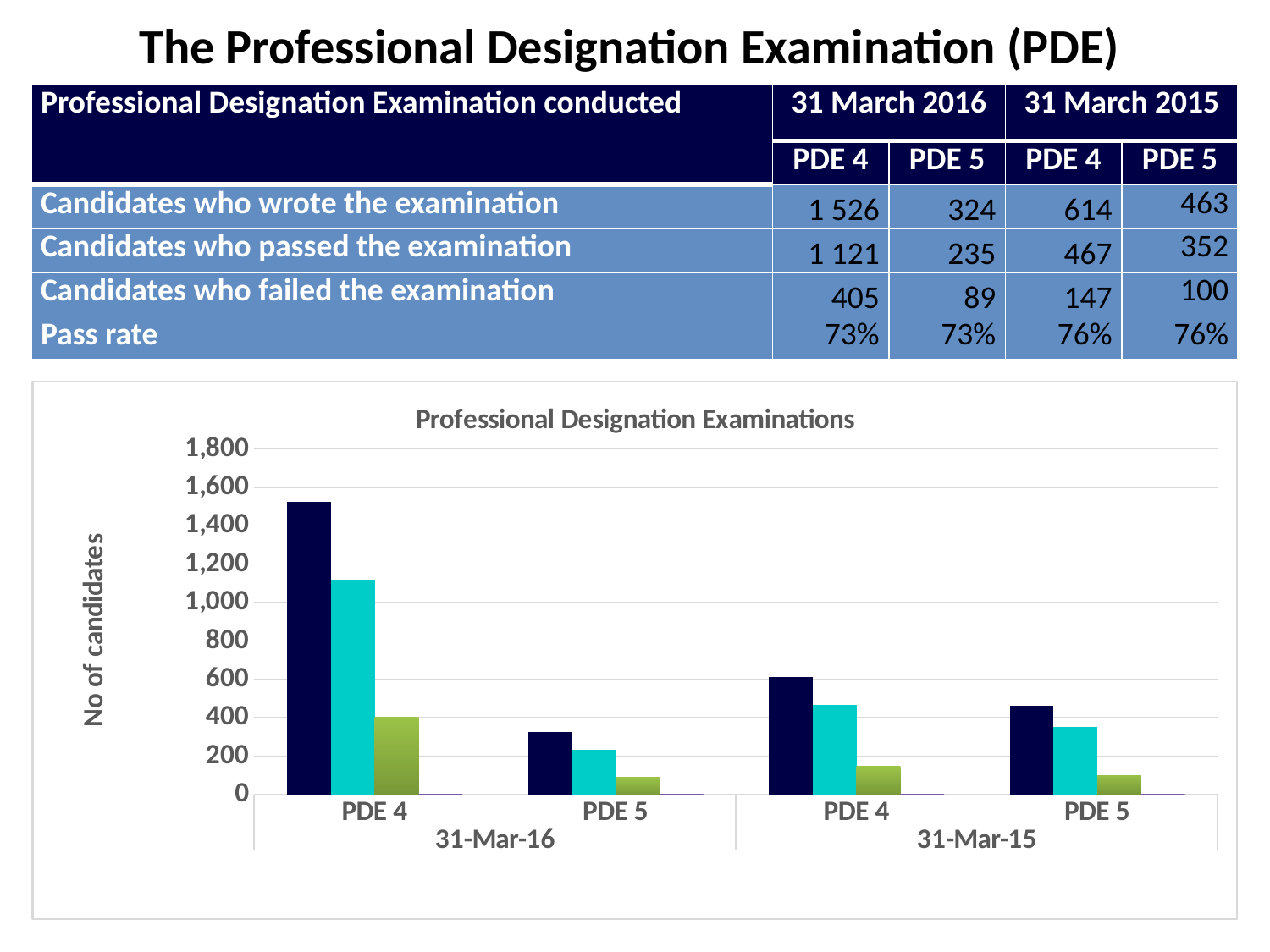
How many category groups (PDE 4 / PDE 5 per date) are shown along the x axis of the chart? 4 In the chart, is the tallest bar for PDE 4 under 31-Mar-16 greater or less than 1,400? greater In the chart, is the tallest bar for PDE 4 under 31-Mar-15 greater or less than 800? less What kind of chart is shown on the slide? bar chart In the chart, is the third (green) bar for PDE 5 under 31-Mar-16 greater or less than 200? less What is the label on the vertical axis of the chart? No of candidates Which category group in the chart contains the tallest bar? PDE 4 under 31-Mar-16 According to the table, how many candidates wrote the PDE 4 examination as at 31 March 2016? 1 526 What is the title of the chart? Professional Designation Examinations According to the table, what is the difference between candidates who wrote and candidates who passed PDE 4 as at 31 March 2016? 405 In the chart, under 31-Mar-15, is the tallest bar for PDE 4 or for PDE 5 larger? PDE 4